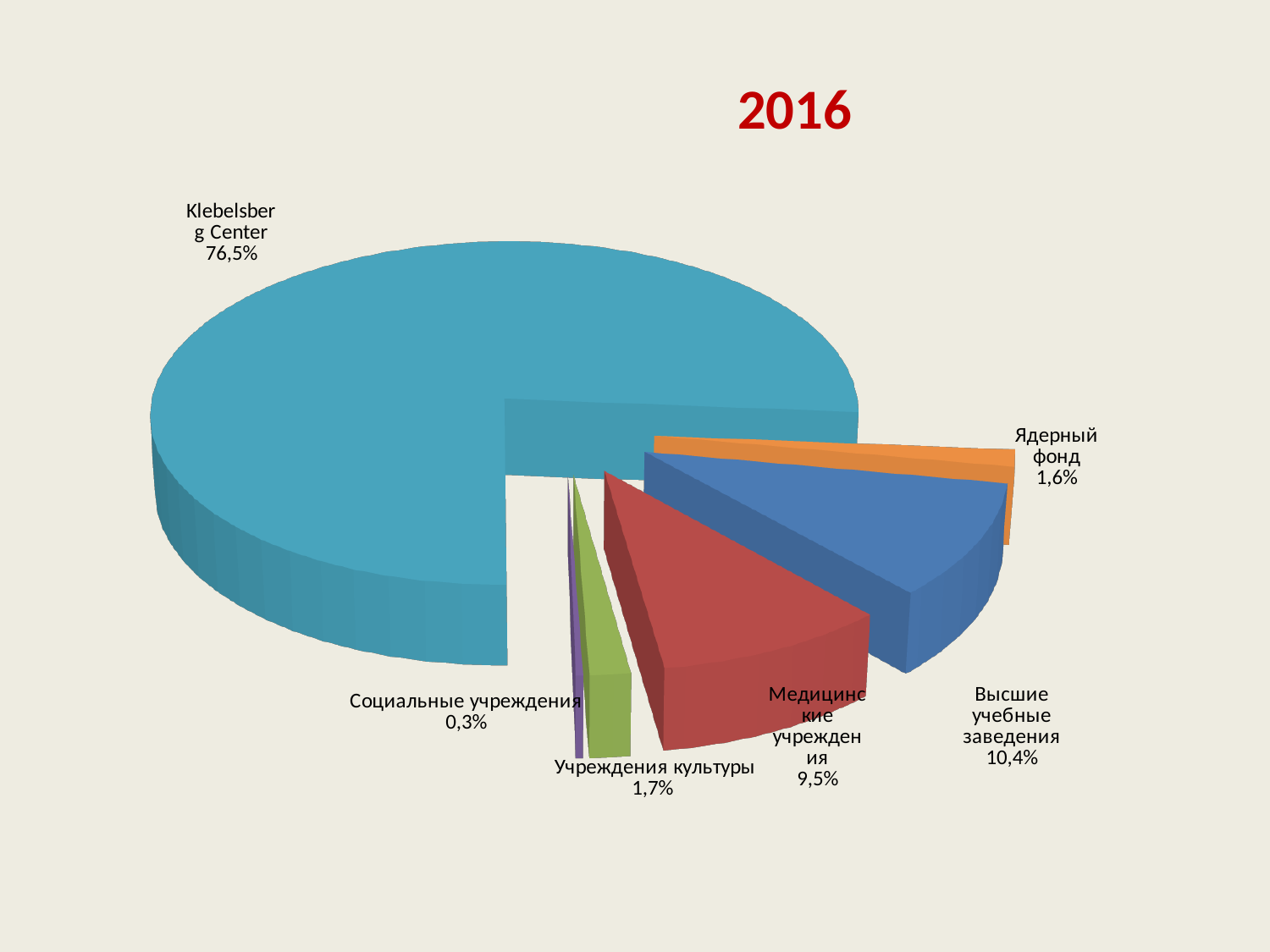
Which is larger, Учреждения культуры or Ядерный фонд? Учреждения культуры What share of the pie does Klebelsberg Center have? 76,5% What is the value for Ядерный фонд? 1,6% Which category has the largest share of the pie? Klebelsberg Center What is the value for Медицинские учреждения? 9,5% What is the value for Социальные учреждения? 0,3% What is the difference between the shares of Высшие учебные заведения and Медицинские учреждения? 0,9% What is the value for Высшие учебные заведения? 10,4% What is the title of the chart? 2016 Which category has the smallest share of the pie? Социальные учреждения What kind of chart is shown on the slide? pie chart How many categories are shown in the pie chart? 6